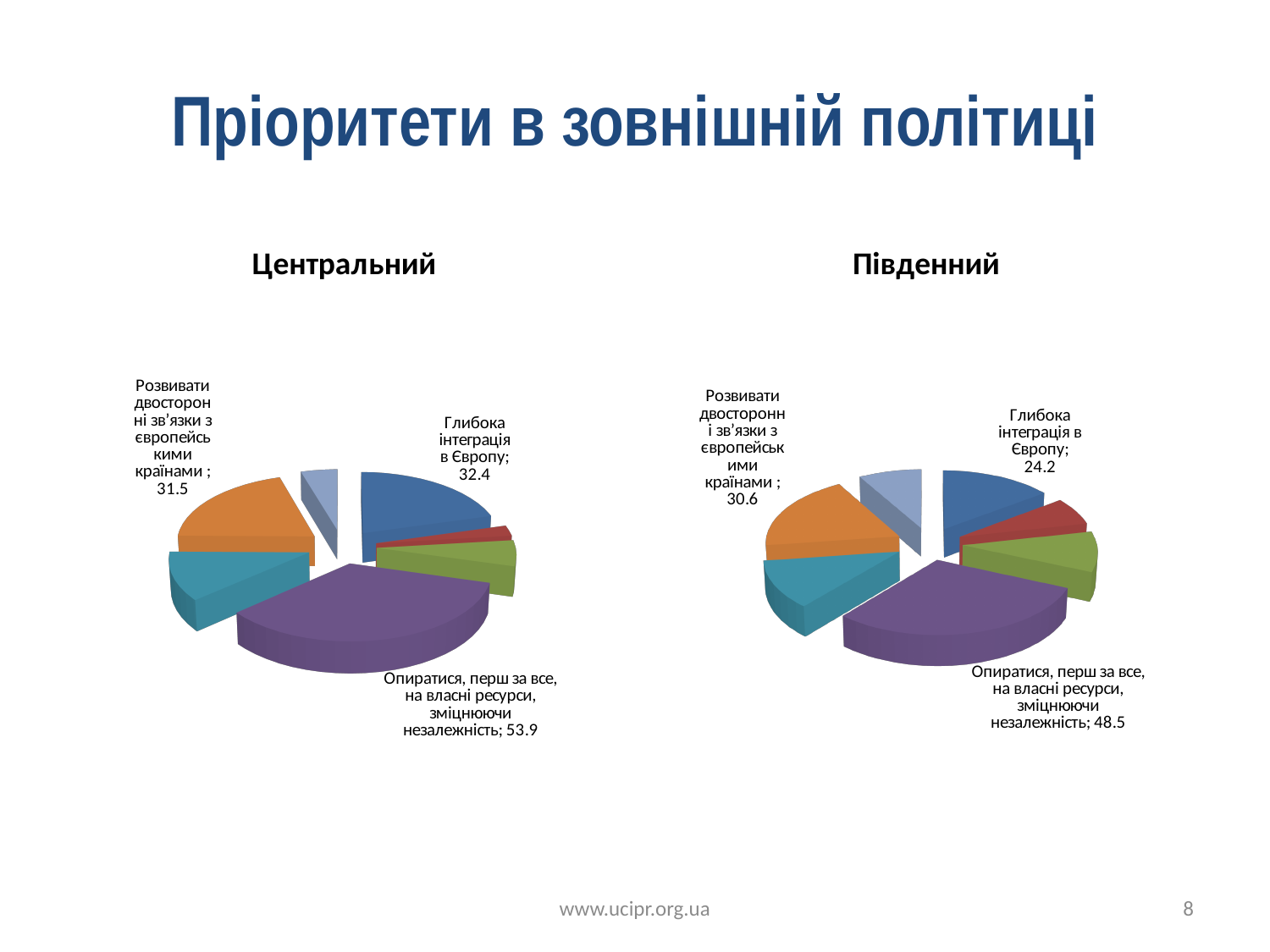
What type of chart is used for the Центральний data? Pie chart In the Центральний chart, what value is shown for 'Опиратися, перш за все, на власні ресурси, зміцнюючи незалежність'? 53.9 In the Центральний chart, what is the difference between the value for 'Опиратися, перш за все, на власні ресурси, зміцнюючи незалежність' and the value for 'Глибока інтеграція в Європу'? 21.5 In the Центральний chart, what value is shown for 'Глибока інтеграція в Європу'? 32.4 In the Південний chart, what is the difference between the value for 'Опиратися, перш за все, на власні ресурси, зміцнюючи незалежність' and the value for 'Розвивати двосторонні зв'язки з європейськими країнами'? 17.9 In the Південний chart, what value is shown for 'Глибока інтеграція в Європу'? 24.2 Which chart shows a higher value for 'Глибока інтеграція в Європу', Центральний or Південний? Центральний In the Центральний chart, what value is shown for 'Розвивати двосторонні зв'язки з європейськими країнами'? 31.5 In the Південний chart, what value is shown for 'Розвивати двосторонні зв'язки з європейськими країнами'? 30.6 What is the title of the chart on the right side of the slide? Південний In the Південний chart, which labeled category has the largest slice? Опиратися, перш за все, на власні ресурси, зміцнюючи незалежність In the Південний chart, what value is shown for 'Опиратися, перш за все, на власні ресурси, зміцнюючи незалежність'? 48.5